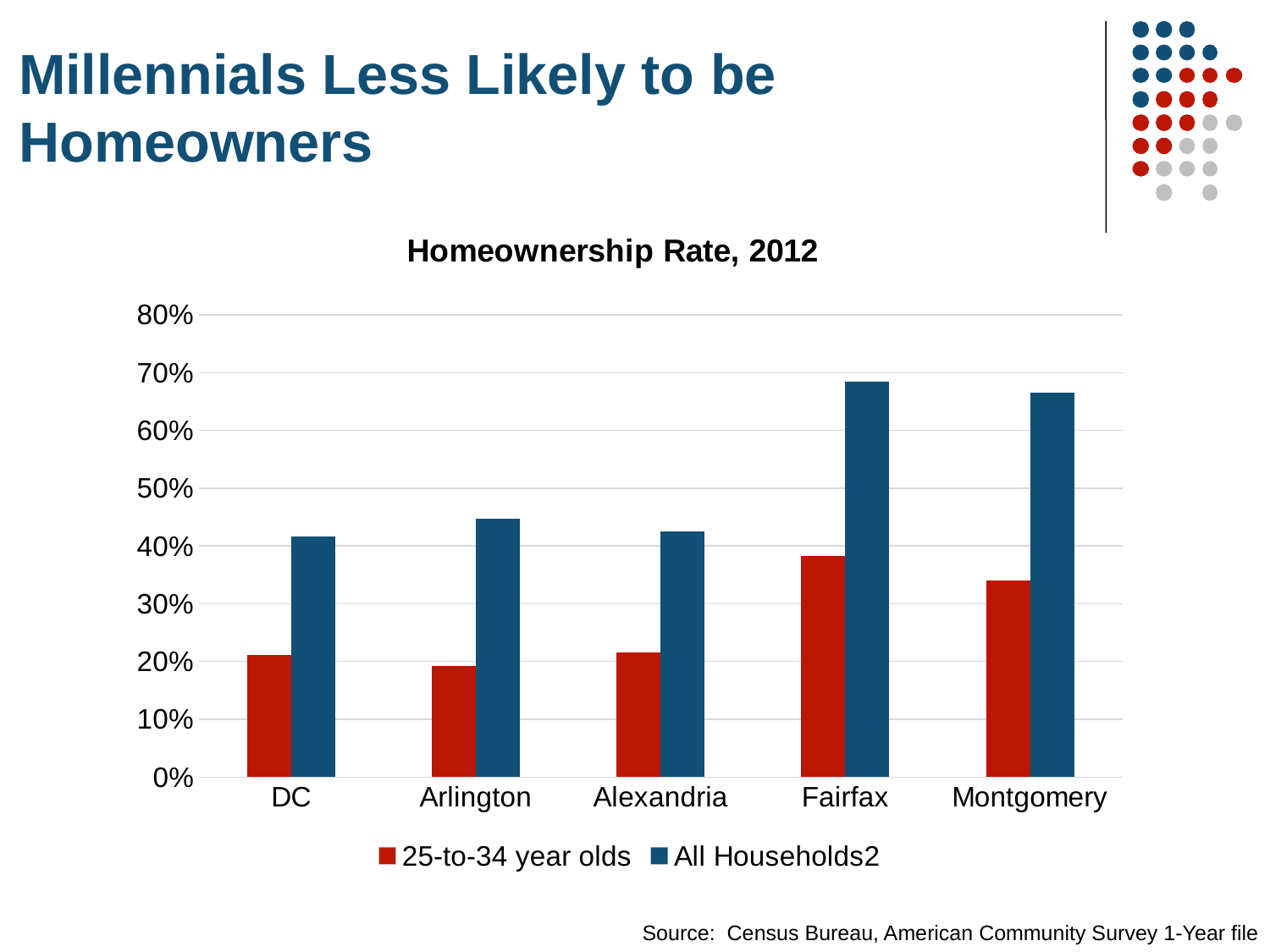
What is the title of the chart? Homeownership Rate, 2012 How many series does the legend list? 2 Is the homeownership rate for 25-to-34 year olds in Fairfax greater or less than 40%? less What type of chart is shown on the slide? bar chart Is the All Households homeownership rate for Arlington greater or less than 40%? greater Is the homeownership rate for 25-to-34 year olds in Montgomery greater or less than 30%? greater How many jurisdictions are shown on the x axis? 5 Which series is shown in red? 25-to-34 year olds Which jurisdiction has the lowest homeownership rate for 25-to-34 year olds? Arlington Which is larger: the 25-to-34 year olds homeownership rate in Fairfax or in Montgomery? Fairfax Which jurisdiction has the highest homeownership rate for 25-to-34 year olds? Fairfax